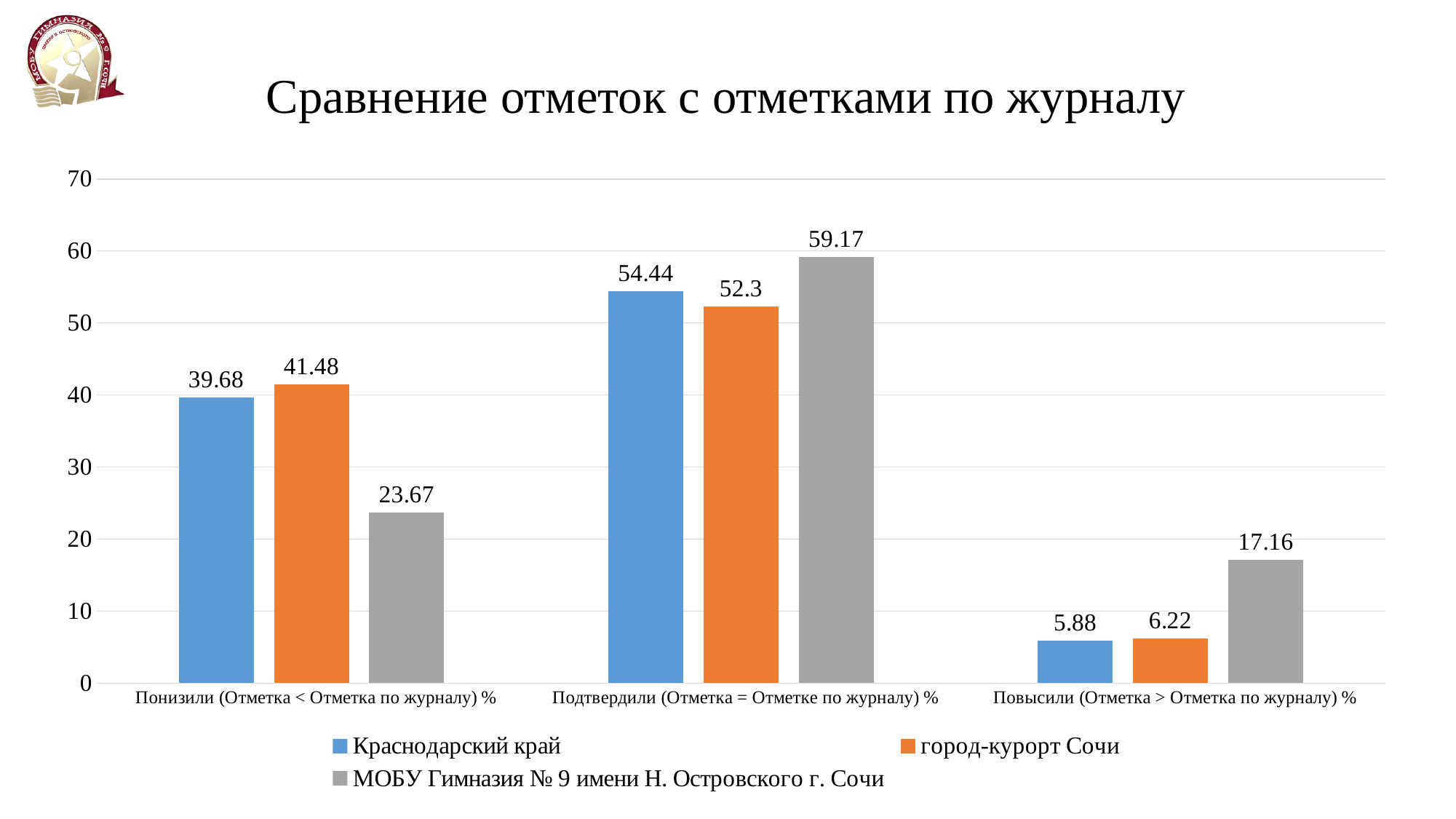
What kind of chart is shown on the slide? bar chart What is the value for город-курорт Сочи in the Повысили (Отметка > Отметка по журналу) % category? 6.22 How many categories are shown on the x axis? 3 Is the value for МОБУ Гимназия № 9 in the Повысили (Отметка > Отметка по журналу) % category greater or less than 20? less What is the value for МОБУ Гимназия № 9 имени Н. Островского г. Сочи in the Подтвердили (Отметка = Отметке по журналу) % category? 59.17 What is the difference between the values for город-курорт Сочи and Краснодарский край in the Понизили (Отметка < Отметка по журналу) % category? 1.8 What is the value for Краснодарский край in the Понизили (Отметка < Отметка по журналу) % category? 39.68 How many series does the legend list? 3 What is the difference between the МОБУ Гимназия № 9 value and the Краснодарский край value in the Повысили (Отметка > Отметка по журналу) % category? 11.28 In the Подтвердили (Отметка = Отметке по журналу) % category, which is larger: Краснодарский край or город-курорт Сочи? Краснодарский край Which series has the highest value in the Подтвердили (Отметка = Отметке по журналу) % category? МОБУ Гимназия № 9 имени Н. Островского г. Сочи Which series has the lowest value in the Понизили (Отметка < Отметка по журналу) % category? МОБУ Гимназия № 9 имени Н. Островского г. Сочи